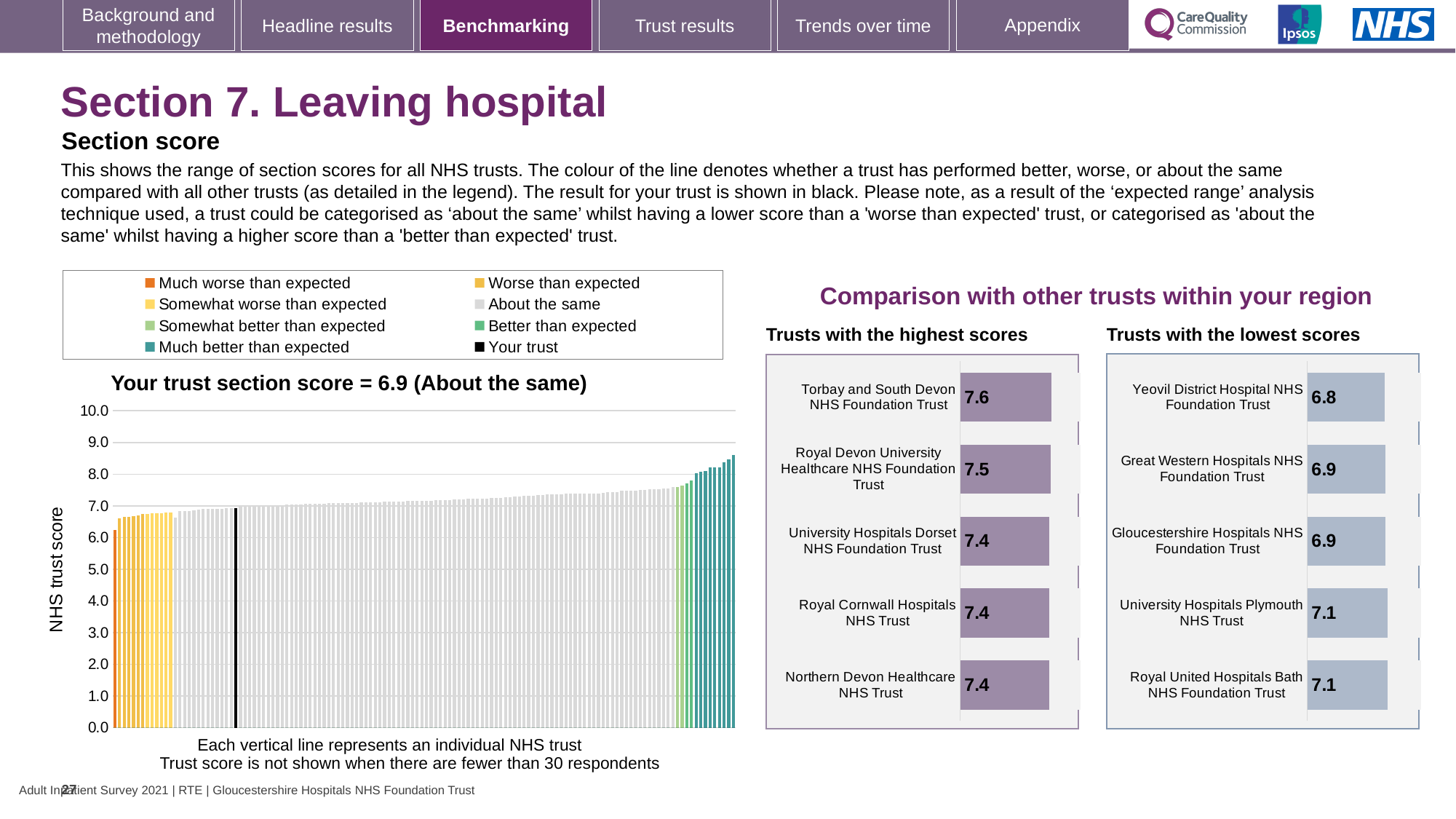
In the 'Trusts with the highest scores' chart, which trust has the highest score? Torbay and South Devon NHS Foundation Trust How many entries does the legend above the main chart on the left list? 8 In the 'Trusts with the lowest scores' chart, what is the score for Royal United Hospitals Bath NHS Foundation Trust? 7.1 In the main chart on the left, what is your trust's section score? 6.9 In the 'Trusts with the lowest scores' chart, what is the score for Yeovil District Hospital NHS Foundation Trust? 6.8 In the 'Trusts with the highest scores' chart, what is the score for Torbay and South Devon NHS Foundation Trust? 7.6 Which has the larger score: Royal Devon University Healthcare NHS Foundation Trust in the highest scores chart or University Hospitals Plymouth NHS Trust in the lowest scores chart? Royal Devon University Healthcare NHS Foundation Trust What is the difference between the score for Torbay and South Devon NHS Foundation Trust in the highest scores chart and the score for Yeovil District Hospital NHS Foundation Trust in the lowest scores chart? 0.8 What kind of chart is the main chart on the left showing the range of section scores for all NHS trusts? Bar chart How many trusts are listed in the 'Trusts with the highest scores' chart? 5 In the main chart on the left, is the value of the tallest bar greater or less than 8.0? greater In the 'Trusts with the lowest scores' chart, which trust has the lowest score? Yeovil District Hospital NHS Foundation Trust